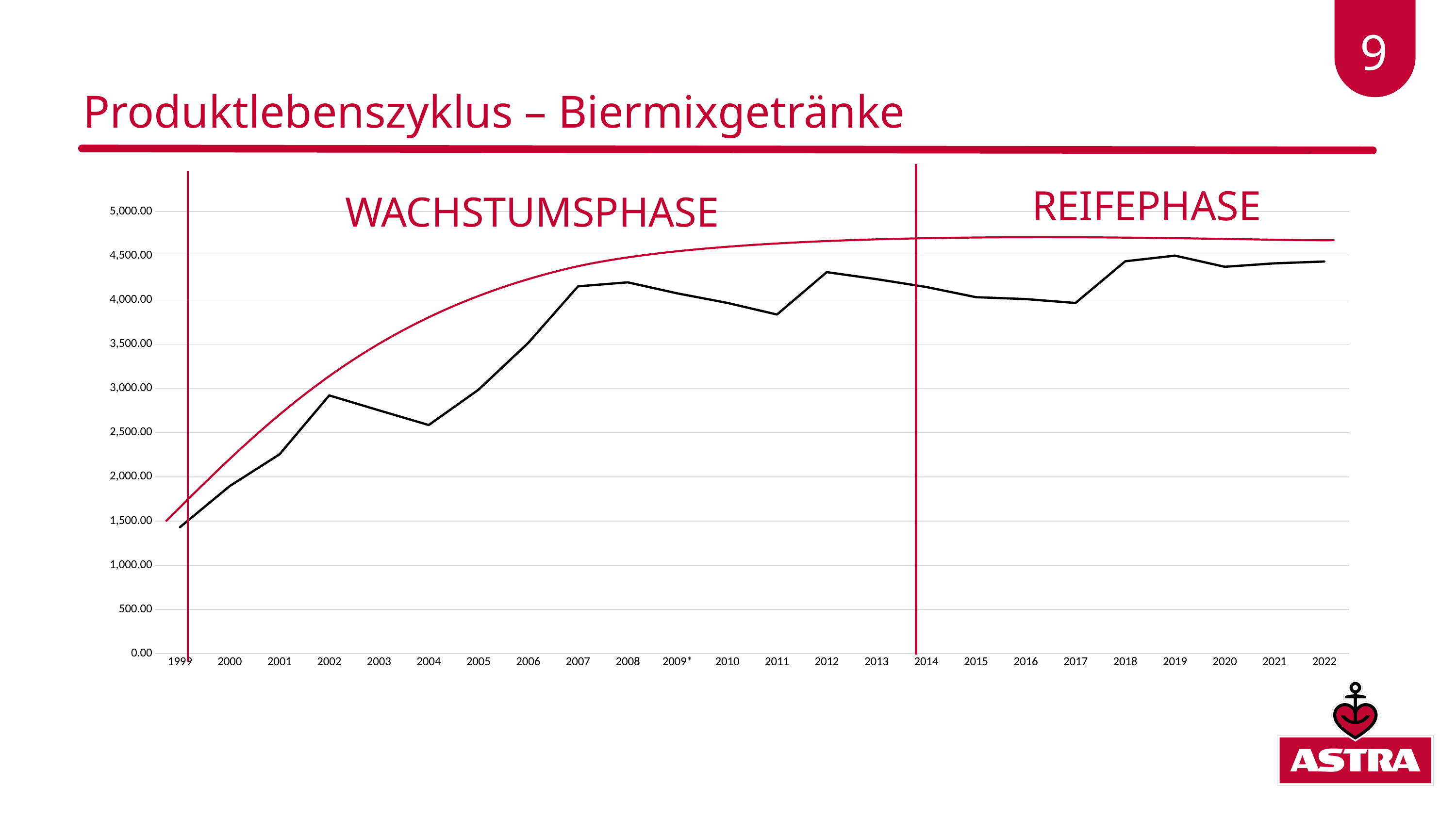
What kind of chart is shown on the slide? Line chart What are the two phases labelled on the chart? WACHSTUMSPHASE and REIFEPHASE Which year has the lowest value on the black line? 1999 Which year has the larger value on the black line, 2007 or 2011? 2007 Is the value of the black line for 2011 greater or less than 4,000? less What is the title of the slide containing the chart? Produktlebenszyklus – Biermixgetränke Which year has the larger value on the black line, 2002 or 2004? 2002 Does the black line overall rise or fall from 1999 to 2022? Rise Is the value of the black line for 2004 greater or less than 3,000? less How many years are labelled along the x axis of the chart? 24 Is the value of the black line for 2002 greater or less than 2,500? greater